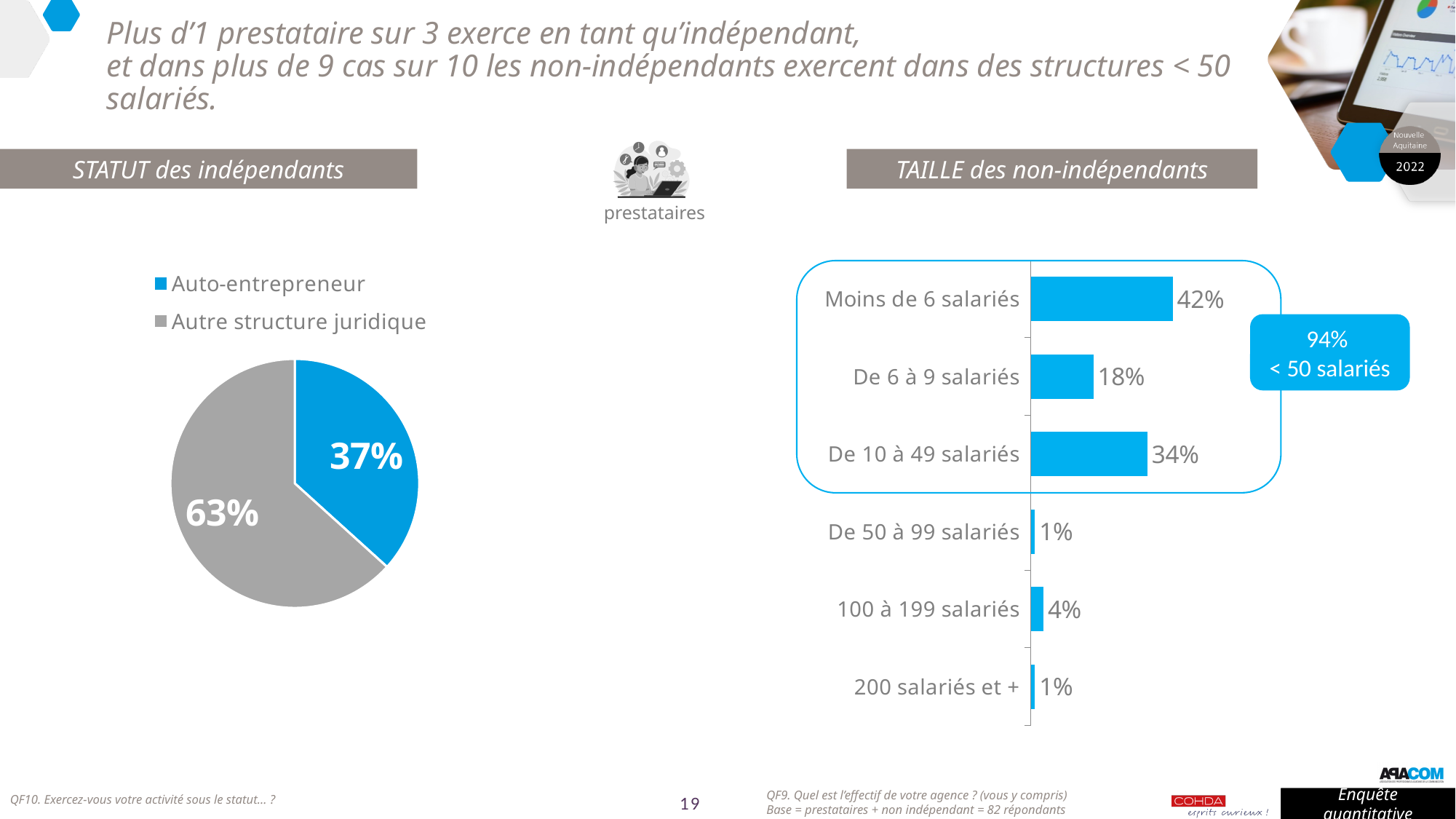
In the bar chart on the right (TAILLE des non-indépendants), what is the value for Moins de 6 salariés? 42% In the bar chart on the right (TAILLE des non-indépendants), which is larger: De 6 à 9 salariés or 100 à 199 salariés? De 6 à 9 salariés In the pie chart on the left (STATUT des indépendants), which category has the larger share? Autre structure juridique In the bar chart on the right (TAILLE des non-indépendants), what is the value for De 10 à 49 salariés? 34% In the pie chart on the left (STATUT des indépendants), what is the difference between the Autre structure juridique share and the Auto-entrepreneur share? 26% In the bar chart on the right (TAILLE des non-indépendants), what is the difference between Moins de 6 salariés and De 6 à 9 salariés? 24% In the pie chart on the left (STATUT des indépendants), what share is Auto-entrepreneur? 37% What kind of chart is shown on the left under STATUT des indépendants? Pie chart In the bar chart on the right (TAILLE des non-indépendants), which category has the highest value? Moins de 6 salariés In the bar chart on the right (TAILLE des non-indépendants), how many categories are shown? 6 What kind of chart is shown on the right under TAILLE des non-indépendants? Bar chart In the pie chart on the left (STATUT des indépendants), what share is Autre structure juridique? 63%